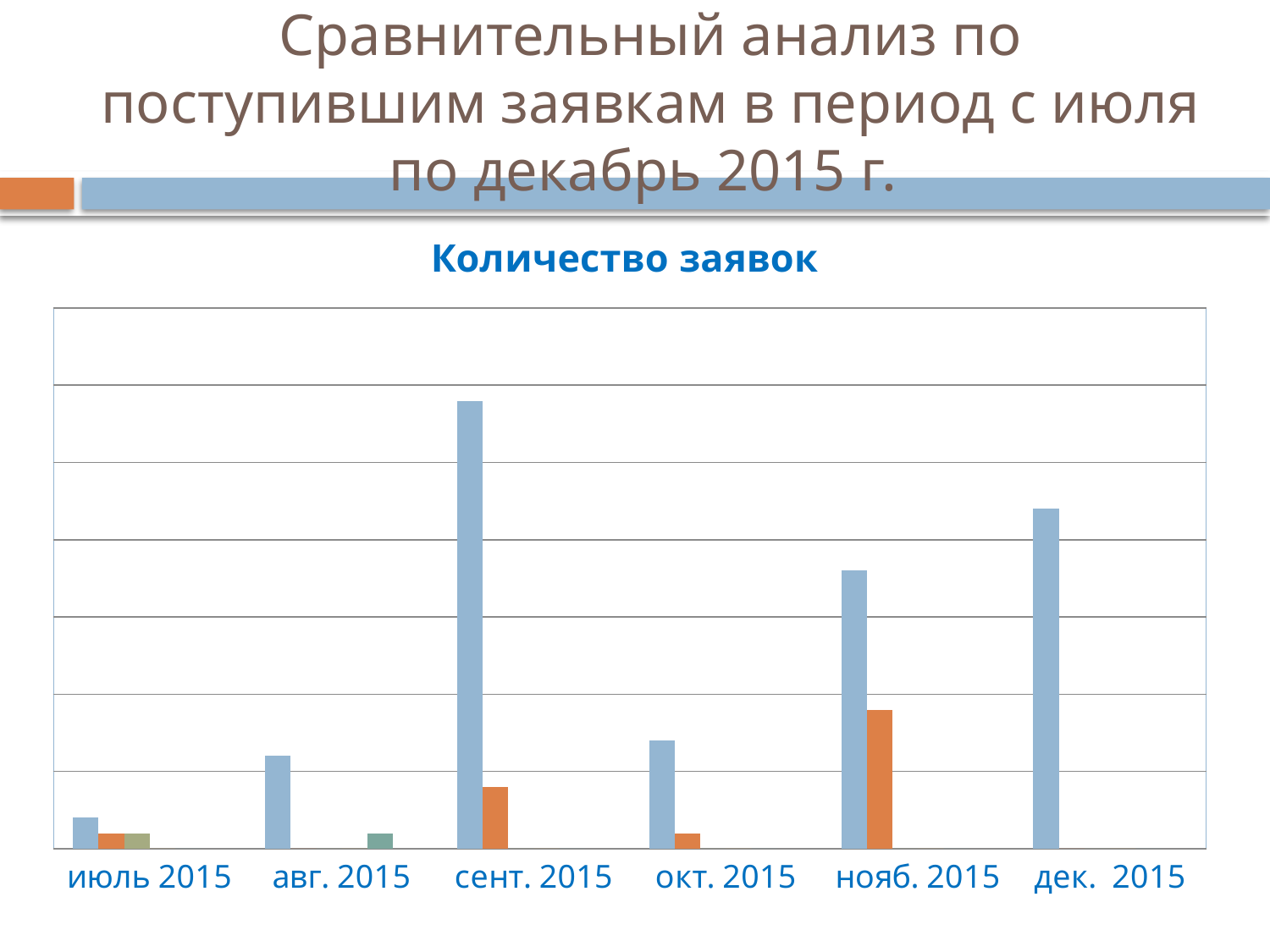
Do the blue bars rise or fall from июль 2015 to сент. 2015? rise How many months (categories) are shown on the x axis of the chart? 6 Which month has the taller blue bar: нояб. 2015 or дек. 2015? дек. 2015 Which month has the tallest bar in the chart? сент. 2015 Which month has the tallest orange bar in the chart? нояб. 2015 What is the title of the chart? Количество заявок Which month has the taller blue bar: сент. 2015 or дек. 2015? сент. 2015 Which month has the taller orange bar: сент. 2015 or окт. 2015? сент. 2015 What kind of chart is shown on the slide? bar chart Which month has the shortest blue bar in the chart? июль 2015 What is the first month shown on the x axis of the chart? июль 2015